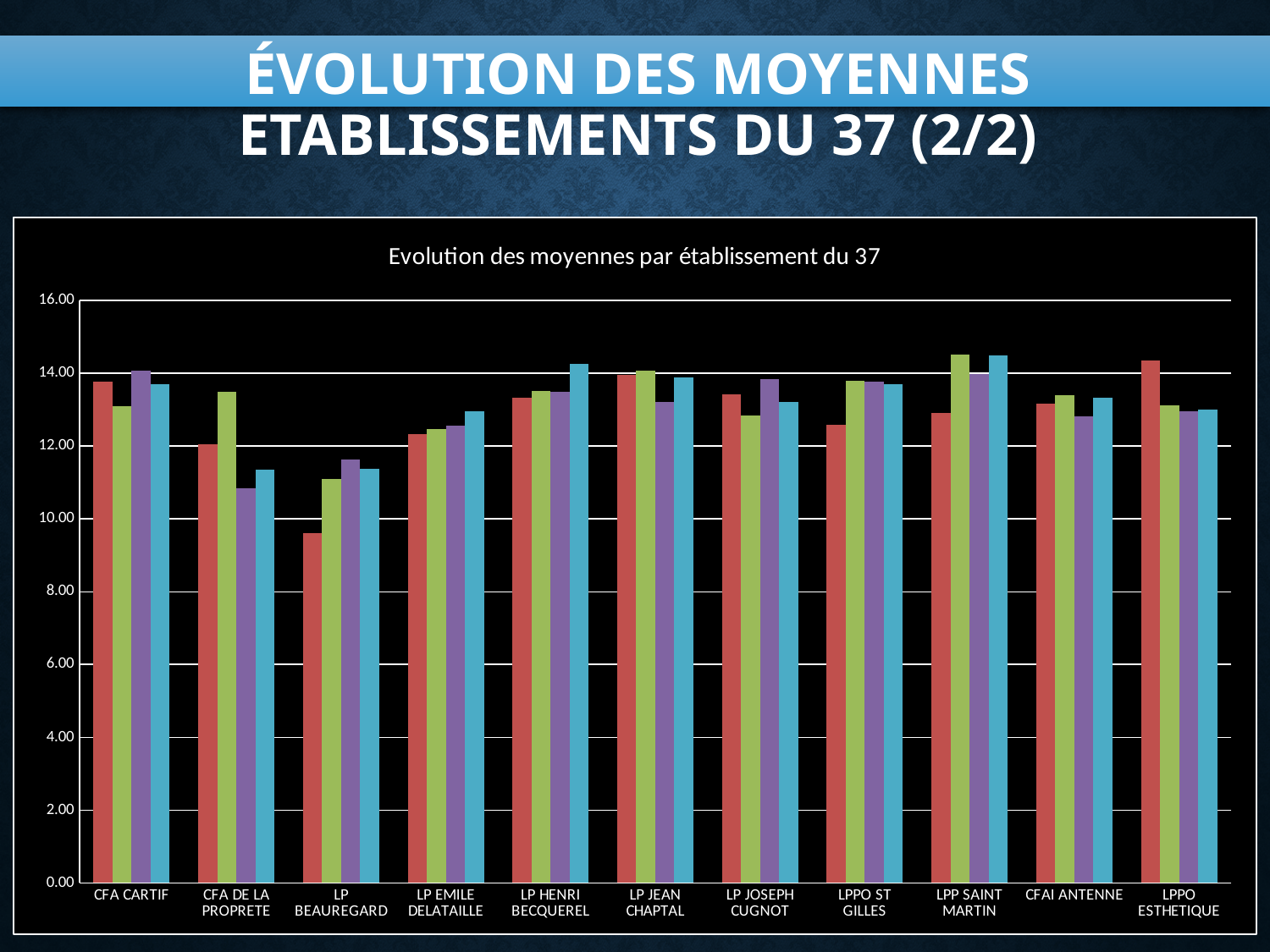
Which is larger: the green bar for CFA DE LA PROPRETE or the purple bar for CFA DE LA PROPRETE? The green bar What type of chart is shown on the slide? Bar chart Which is larger: the red bar for CFA CARTIF or the red bar for LP BEAUREGARD? CFA CARTIF Is the value of the red bar for CFA CARTIF greater or less than 14.00? less What is the title of the chart? Evolution des moyennes par établissement du 37 Is the value of the blue bar for LP HENRI BECQUEREL greater or less than 14.00? greater Is the value of the purple bar for CFA DE LA PROPRETE greater or less than 12.00? less How many bars are shown for each establishment in the chart? 4 How many establishments (categories) are shown on the x axis of the chart? 11 Which establishment has the lowest red bar in the chart? LP BEAUREGARD